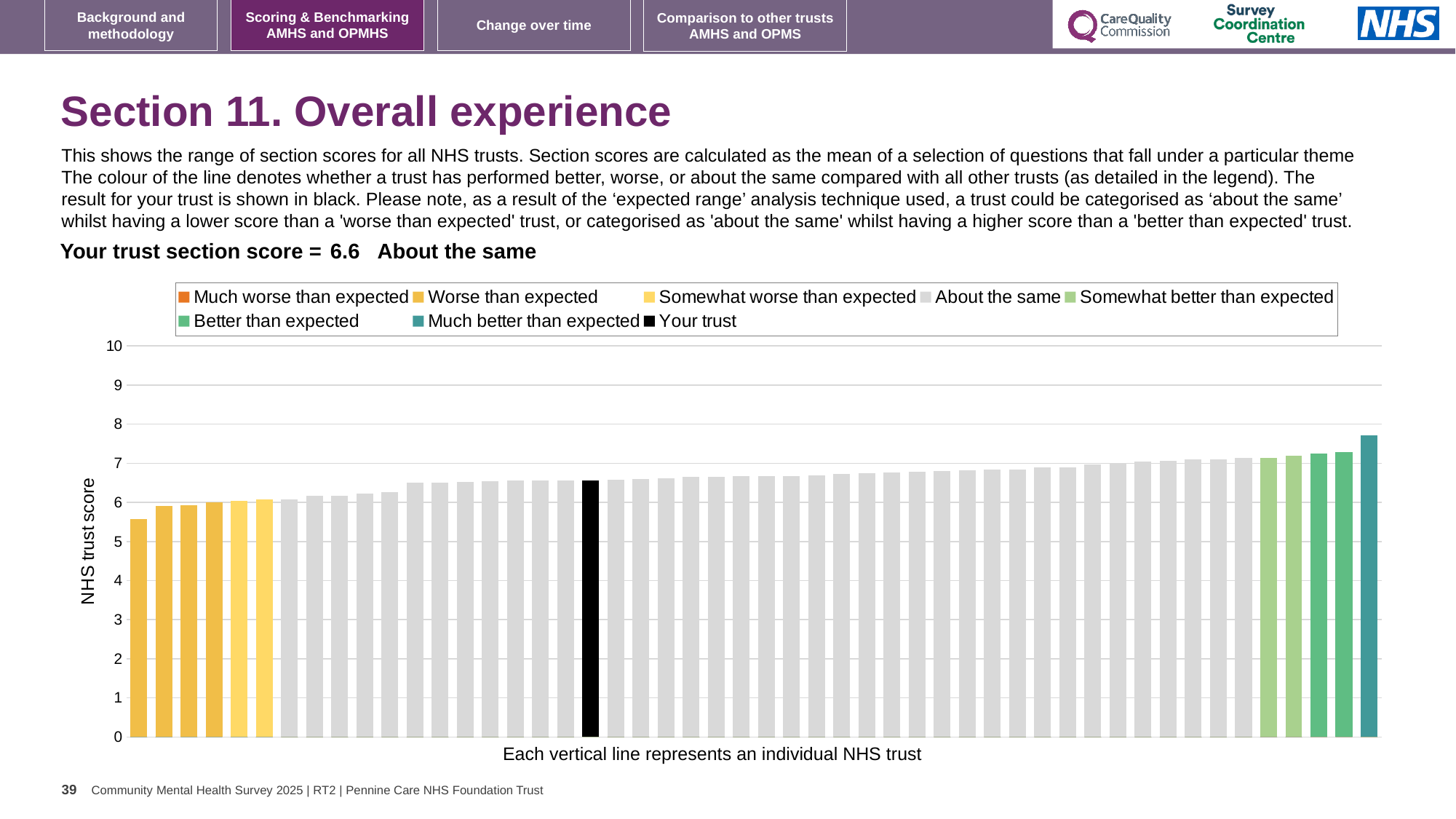
What is the label on the vertical axis of the chart? NHS trust score What is the section score for your trust shown on the slide? 6.6 Is the value of the tallest bar in the chart greater or less than 7? greater Do the bar values rise or fall from left to right along the x axis? rise Is the value of the black 'Your trust' bar greater or less than 6? greater Is the value of the tallest bar in the chart greater or less than 8? less How many entries does the chart legend list? 8 What kind of chart is shown on the slide? bar chart Which category is your trust placed in for this section? About the same Which legend category does the tallest bar in the chart belong to? Much better than expected